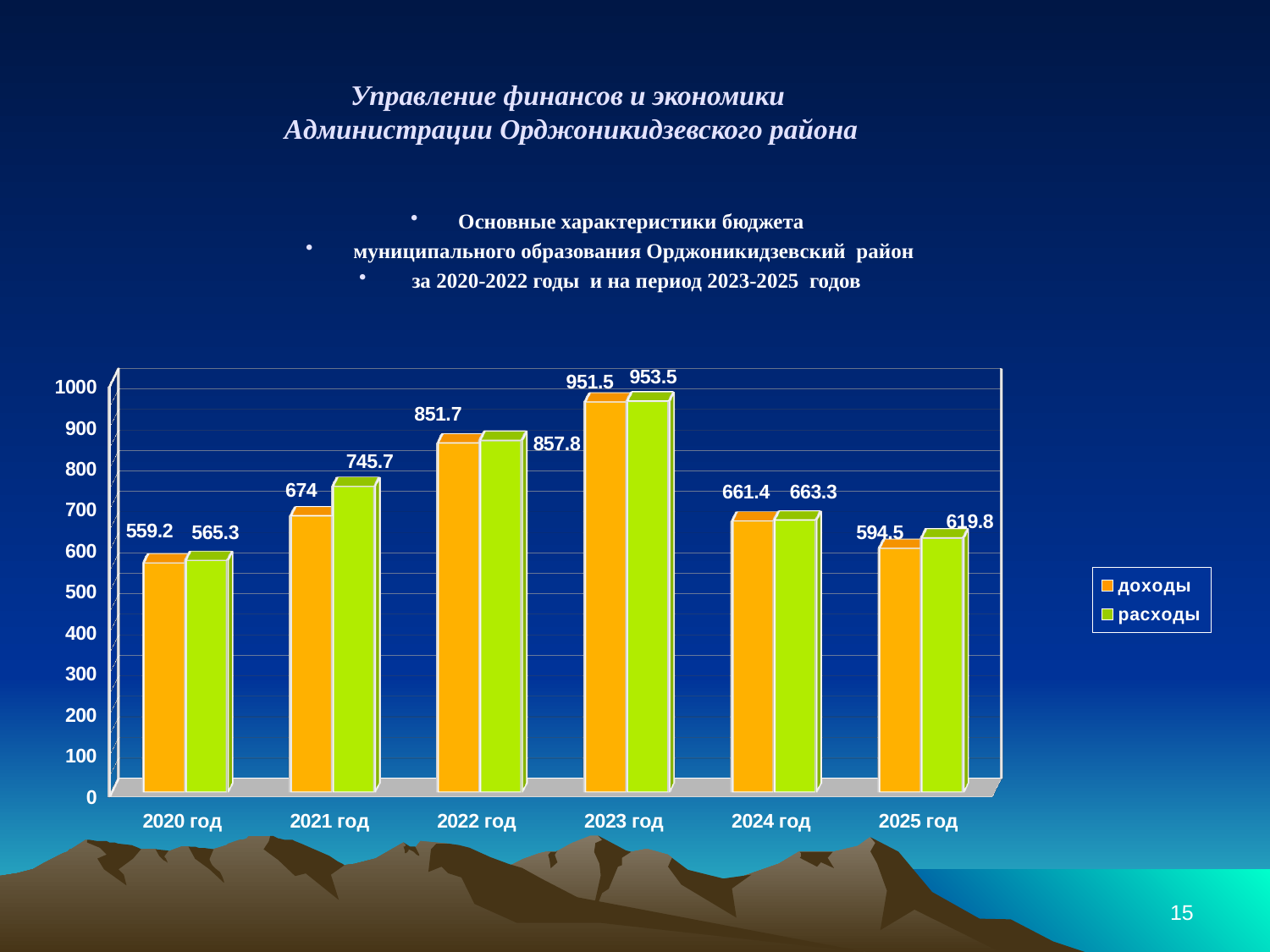
What is the value of расходы for 2025 год? 619.8 How many years are shown on the x axis? 6 What is the value of расходы for 2021 год? 745.7 Which is larger in 2025 год: доходы or расходы? расходы What is the value of доходы for 2020 год? 559.2 In which year is расходы the lowest? 2020 год How many series does the legend list? 2 In which year is доходы the highest? 2023 год Which colour represents расходы in the legend? green What kind of chart is shown on the slide? bar chart What is the difference between расходы and доходы in 2021 год? 71.7 Is the value of доходы for 2022 год greater or less than 800? greater